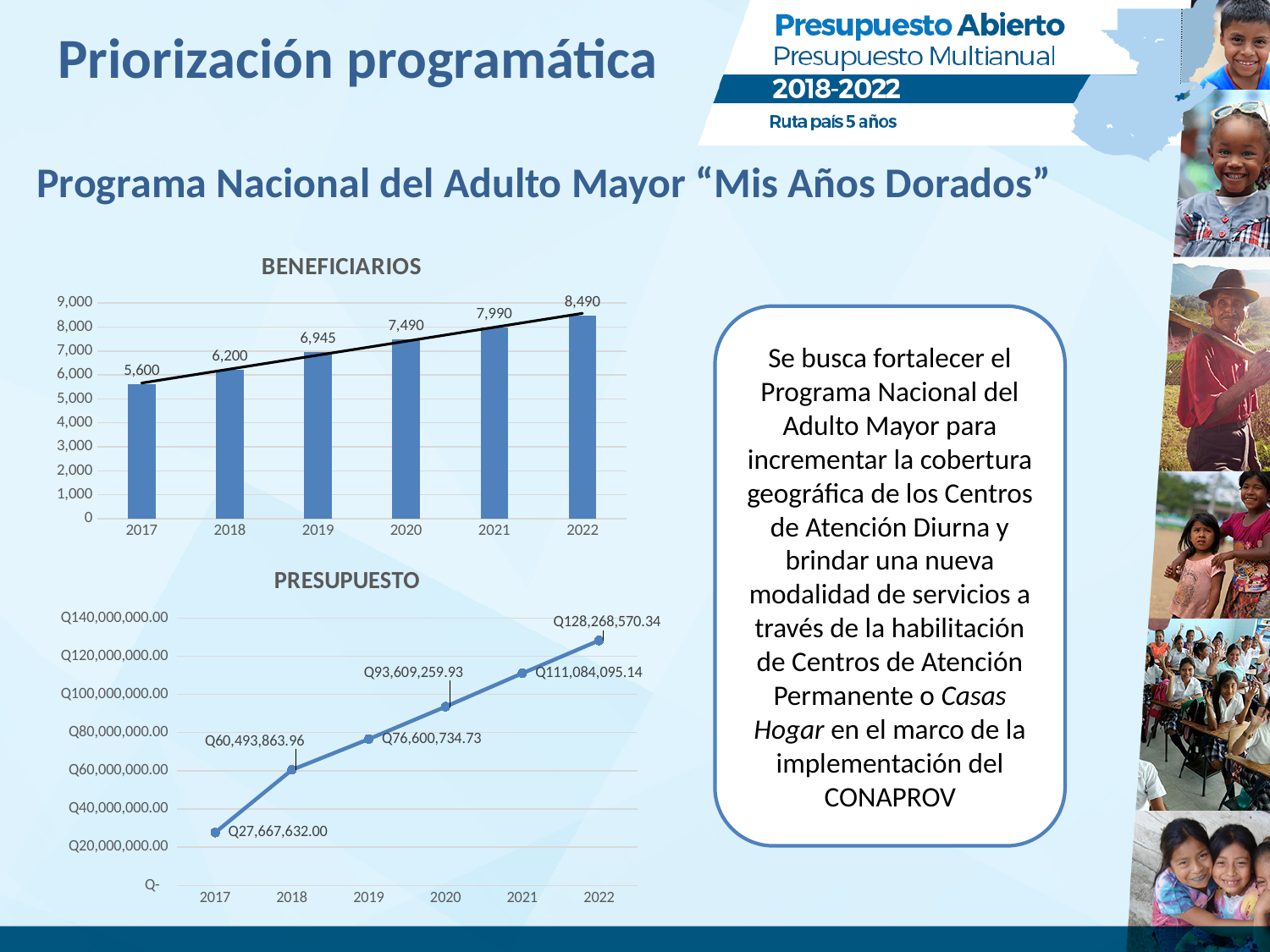
In the PRESUPUESTO chart, is the value for 2021 larger or smaller than the value for 2019? larger What kind of chart is the PRESUPUESTO chart? line chart In the BENEFICIARIOS chart, what is the value for 2019? 6,945 In the BENEFICIARIOS chart, do the values rise or fall from 2017 to 2022? rise In the PRESUPUESTO chart, what is the value for 2020? Q93,609,259.93 In the BENEFICIARIOS chart, what is the value for 2022? 8,490 In the PRESUPUESTO chart, what is the value for 2017? Q27,667,632.00 In the BENEFICIARIOS chart, which year has the lowest value? 2017 In the BENEFICIARIOS chart, what is the difference between the values for 2022 and 2017? 2,890 In the BENEFICIARIOS chart, how many years are shown on the x axis? 6 What kind of chart is the BENEFICIARIOS chart? bar chart In the PRESUPUESTO chart, which year has the highest value? 2022